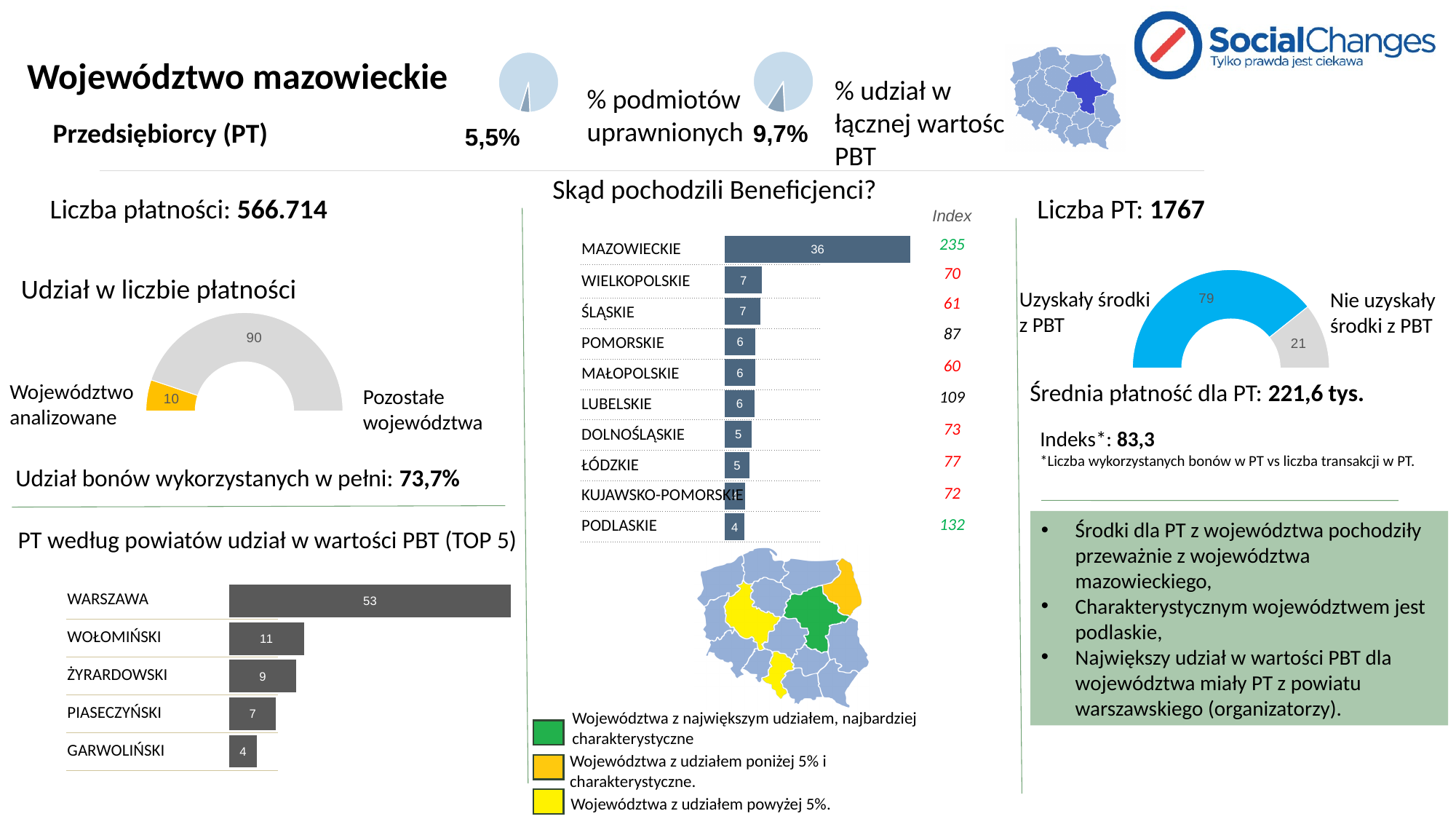
In the 'Skąd pochodzili Beneficjenci?' chart, what is the value for MAZOWIECKIE? 36 In the 'PT według powiatów udział w wartości PBT (TOP 5)' chart, what is the difference between WARSZAWA and WOŁOMIŃSKI? 42 In the 'Udział w liczbie płatności' chart, what is the value for 'Województwo analizowane'? 10 In the 'PT według powiatów udział w wartości PBT (TOP 5)' chart, what is the value for WARSZAWA? 53 In the 'Skąd pochodzili Beneficjenci?' chart, which voivodeship has the highest value? MAZOWIECKIE How many powiats are shown in the 'PT według powiatów udział w wartości PBT (TOP 5)' chart? 5 What type of chart is 'Skąd pochodzili Beneficjenci?'? Bar chart In the 'PT według powiatów udział w wartości PBT (TOP 5)' chart, which powiat has the lowest value? GARWOLIŃSKI In the 'Skąd pochodzili Beneficjenci?' chart, what is the value for PODLASKIE? 4 In the semi-donut chart under 'Liczba PT: 1767', what is the difference between 'Uzyskały środki z PBT' and 'Nie uzyskały środki z PBT'? 58 In the 'Skąd pochodzili Beneficjenci?' chart, which is larger: the value for WIELKOPOLSKIE or the value for DOLNOŚLĄSKIE? WIELKOPOLSKIE In the semi-donut chart under 'Liczba PT: 1767', what is the value for 'Uzyskały środki z PBT'? 79